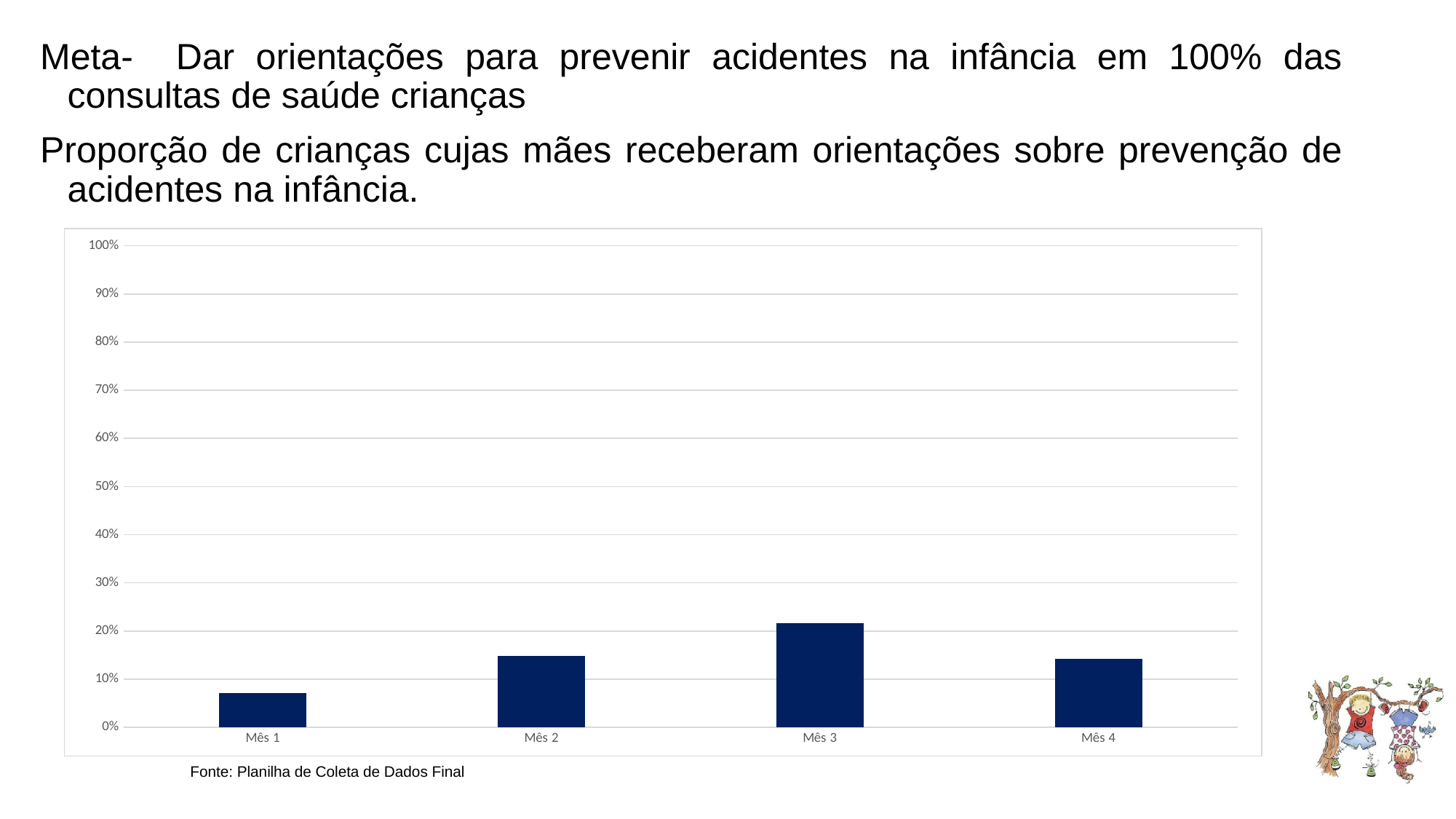
Which month has the highest bar in the chart? Mês 3 Which is larger, the value for Mês 3 or the value for Mês 1? Mês 3 What is the highest value shown on the chart's vertical axis? 100% Is the value for Mês 3 greater or less than 20%? greater What kind of chart is shown on the slide? bar chart Do the values rise or fall from Mês 1 to Mês 3? rise Which month has the lowest bar in the chart? Mês 1 Is the value for Mês 2 greater or less than 10%? greater Is the value for Mês 3 greater or less than 30%? less How many months (categories) are plotted on the x axis of the chart? 4